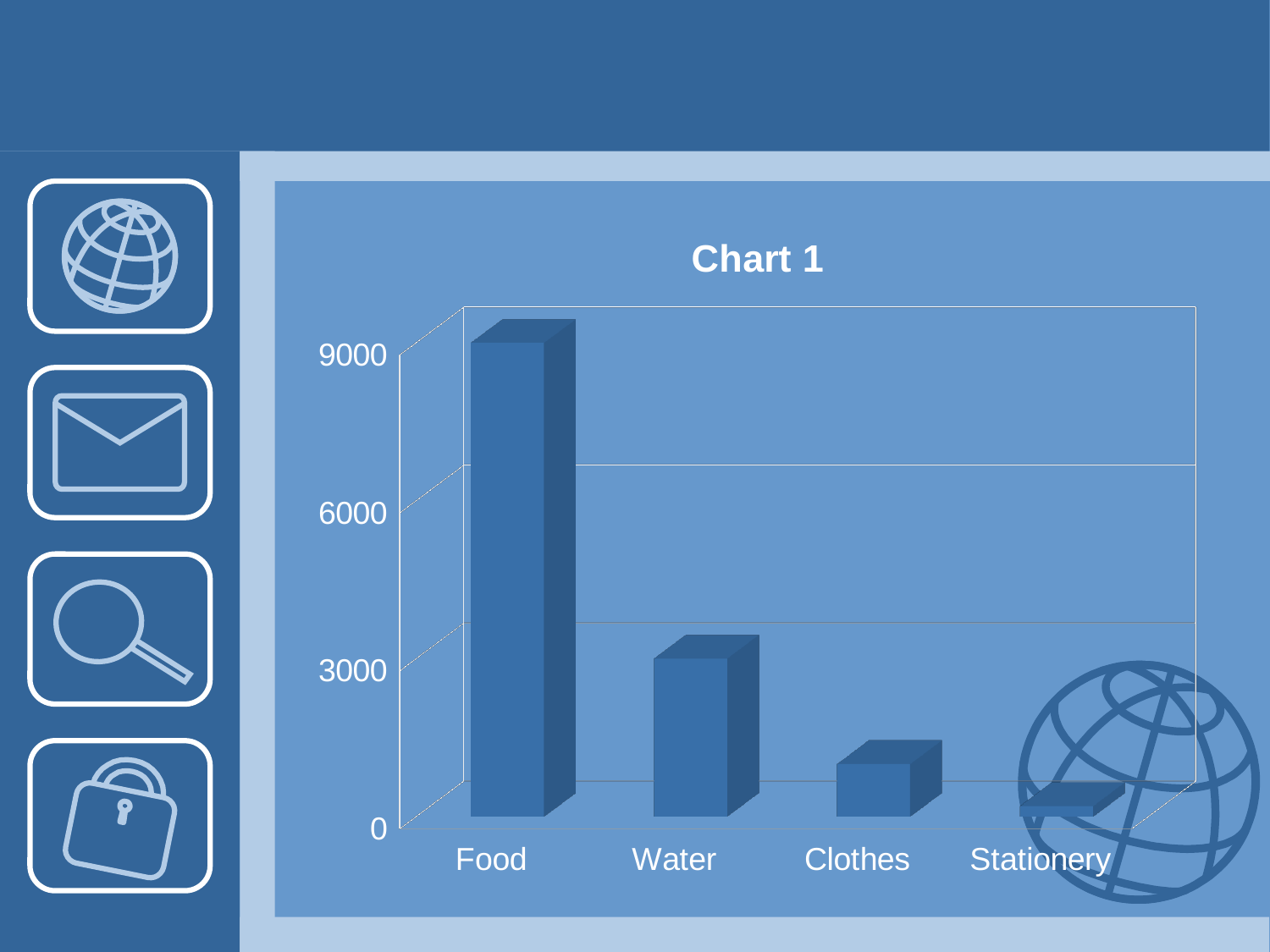
How many categories are shown on the x axis of the chart? 4 Is the value for Stationery greater or less than 3000? less Is the value for Water greater or less than 6000? less What kind of chart is shown on the slide? bar chart Is the value for Food greater or less than 6000? greater Do the values rise or fall from Food to Stationery along the x axis? fall Which has a larger value, Water or Clothes? Water Which category has the lowest value in the chart? Stationery Which has a larger value, Clothes or Stationery? Clothes Which category has the highest value in the chart? Food What is the title of the chart? Chart 1